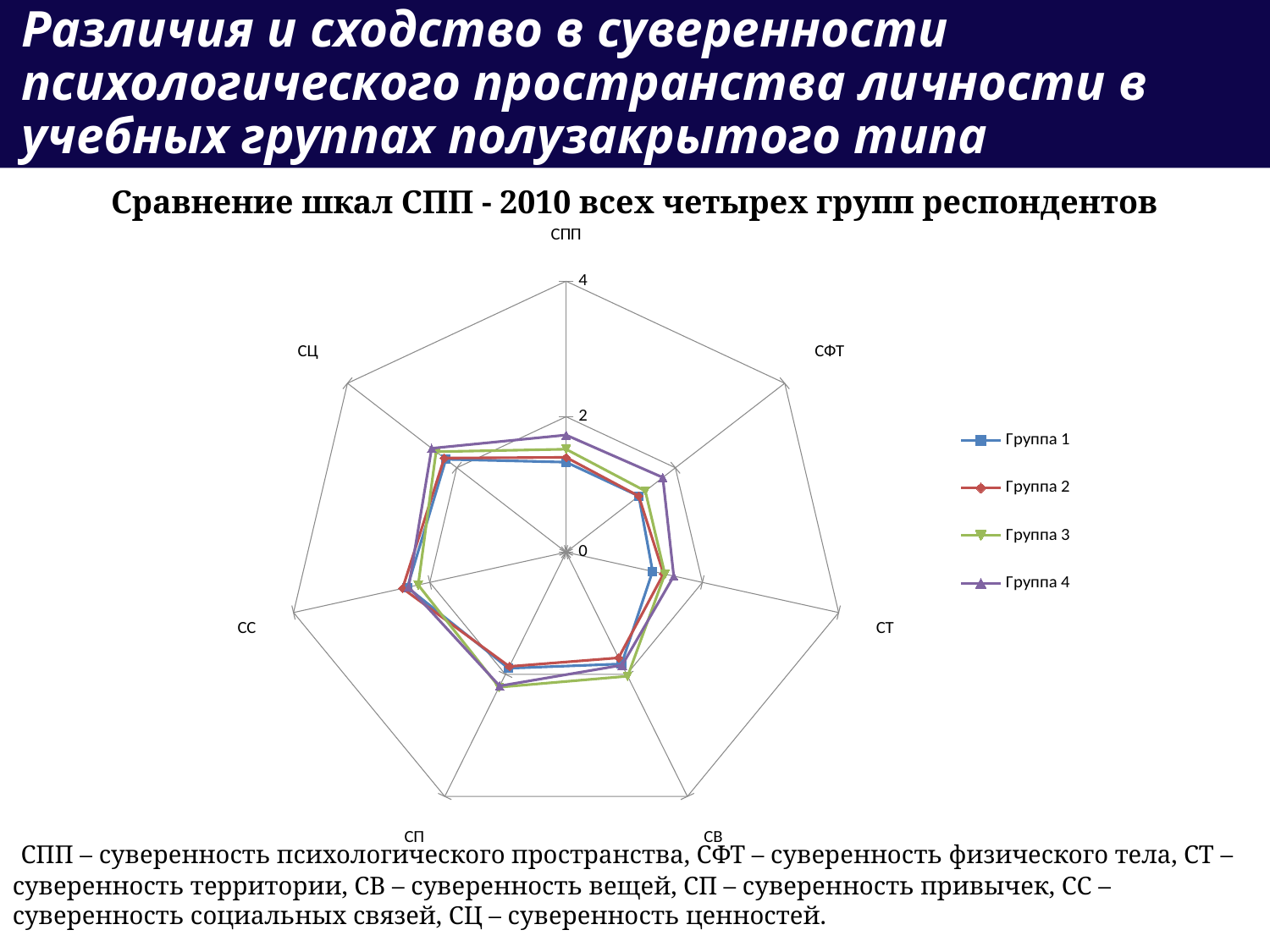
Which group has the lowest value on the СПП scale? Группа 1 How many scales (axes) are plotted on the radar chart? 7 Is the value of Группа 4 on the СПП scale greater or less than 2? less Which group has the highest value on the СПП scale? Группа 4 Which series are listed in the legend? Группа 1, Группа 2, Группа 3, Группа 4 Which group has the highest value on the СФТ scale? Группа 4 On the СЦ scale, which is larger: the value of Группа 4 or Группа 1? Группа 4 On the СП scale, which is larger: the value of Группа 3 or Группа 1? Группа 3 What is the title of the chart? Сравнение шкал СПП - 2010 всех четырех групп респондентов Is the value of Группа 1 on the СТ scale greater or less than 2? less How many series does the legend list? 4 What kind of chart is shown on the slide? Radar chart